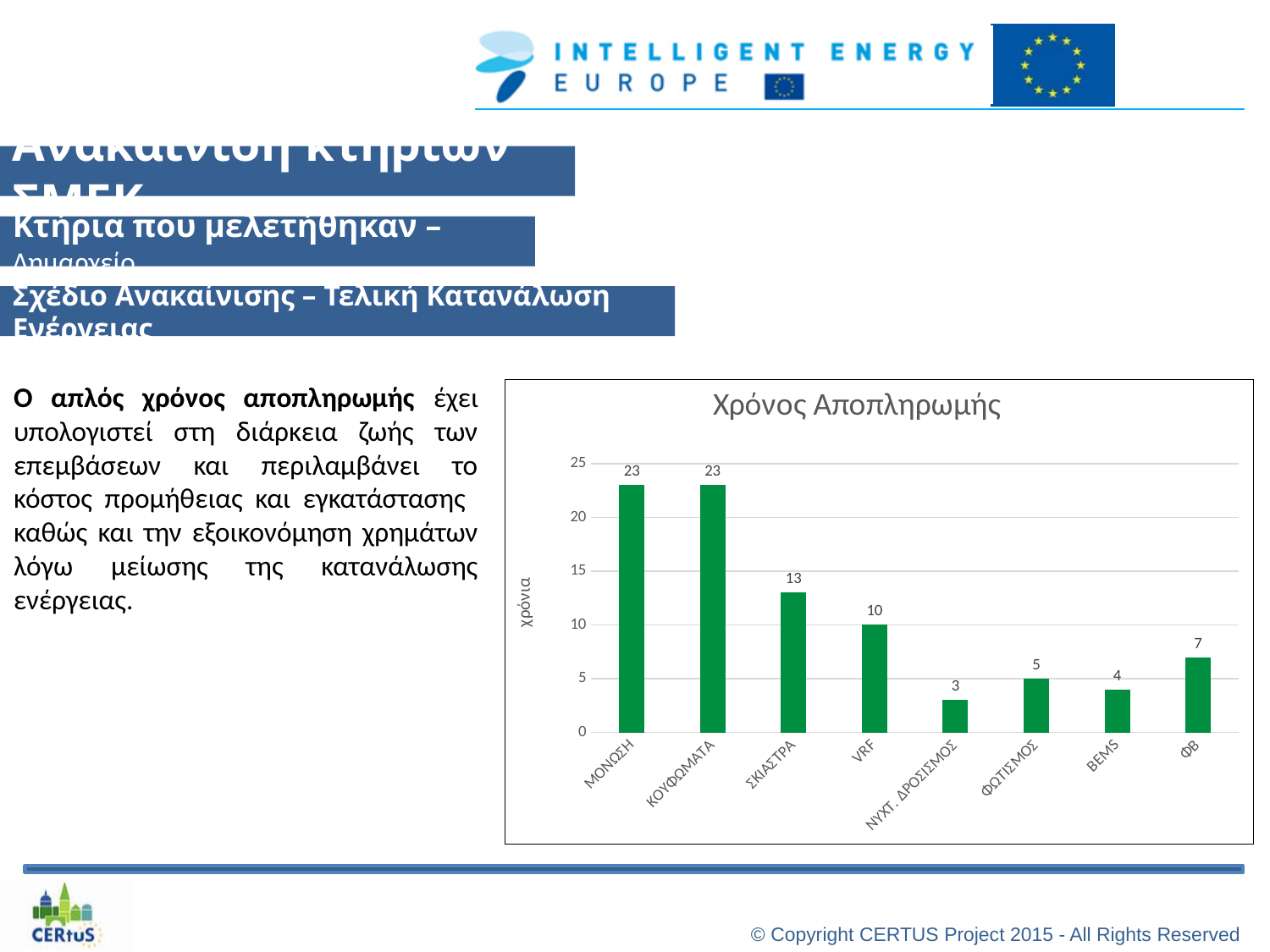
What kind of chart is shown on the slide? bar chart What is the value for BEMS? 4 How many categories are shown on the x axis of the chart? 8 What is the difference between the values for ΜΟΝΩΣΗ and ΣΚΙΑΣΤΡΑ? 10 Which category has the lowest payback time? ΝΥΧΤ. ΔΡΟΣΙΣΜΟΣ Which has a larger value, VRF or ΦΒ? VRF Is the value for ΚΟΥΦΩΜΑΤΑ greater or less than 20? greater What value is shown for VRF in the Χρόνος Αποπληρωμής chart? 10 What is the value for ΦΒ? 7 What is the title of the chart? Χρόνος Αποπληρωμής What is the difference between the values for ΦΩΤΙΣΜΟΣ and BEMS? 1 What is the payback time value shown for ΣΚΙΑΣΤΡΑ? 13